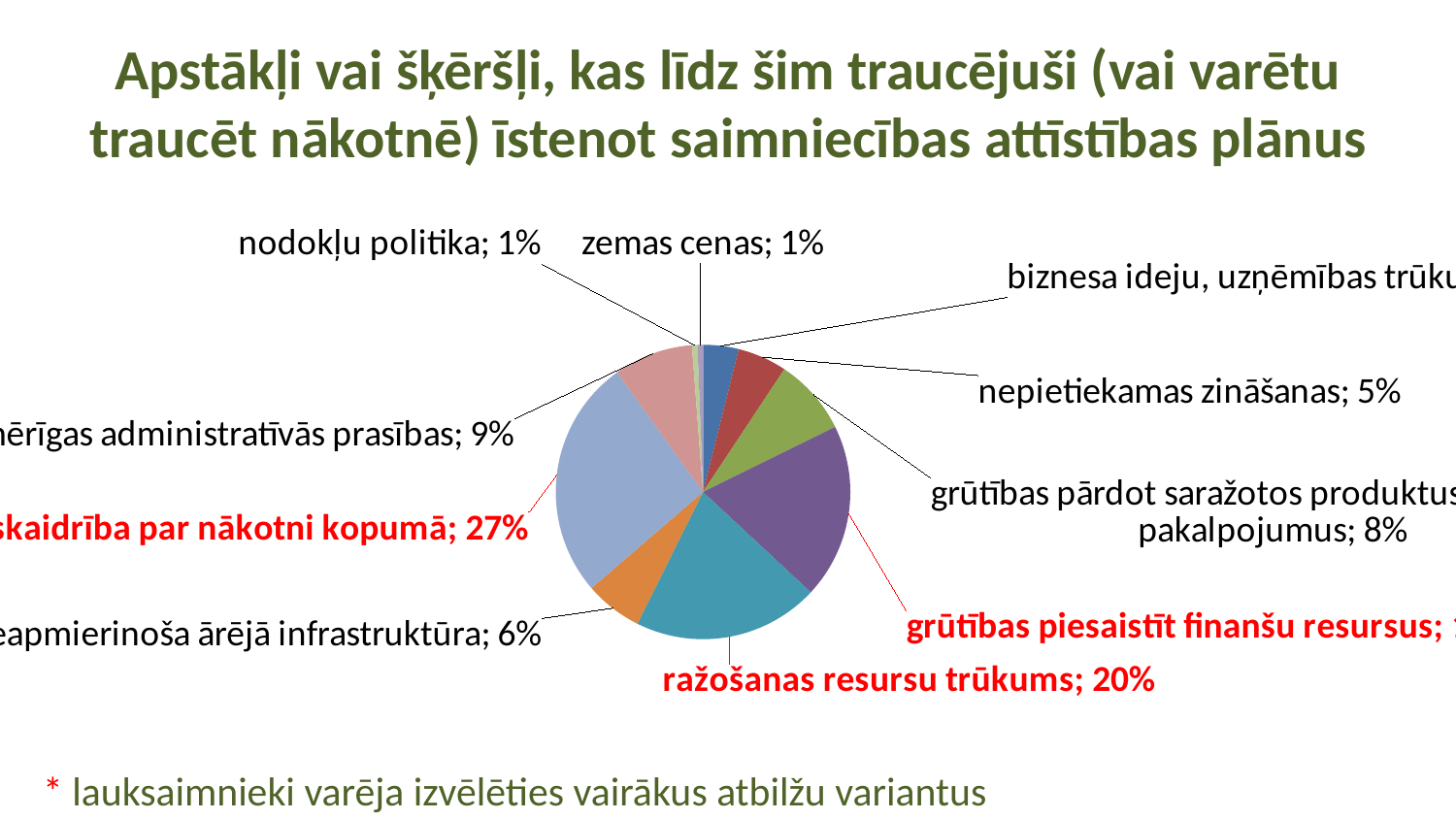
What does the footnote marked with an asterisk below the chart say? lauksaimnieki varēja izvēlēties vairākus atbilžu variantus How many percentage points larger is "ražošanas resursu trūkums" than "nepietiekamas zināšanas"? 15 percentage points What is the percentage of the largest slice in the pie chart? 27% Which has a larger share: "grūtības pārdot saražotos produktus/pakalpojumus" or "nepietiekamas zināšanas"? grūtības pārdot saražotos produktus/pakalpojumus What percentage is shown for "nepietiekamas zināšanas"? 5% What percentage is shown for "zemas cenas"? 1% What percentage is shown for "nodokļu politika"? 1% What is the smallest percentage value shown on the pie chart? 1% What type of chart is shown on the slide? pie chart How many slices does the pie chart have? 10 What percentage is shown for "grūtības pārdot saražotos produktus/pakalpojumus"? 8% What share of the pie does "ražošanas resursu trūkums" have? 20%